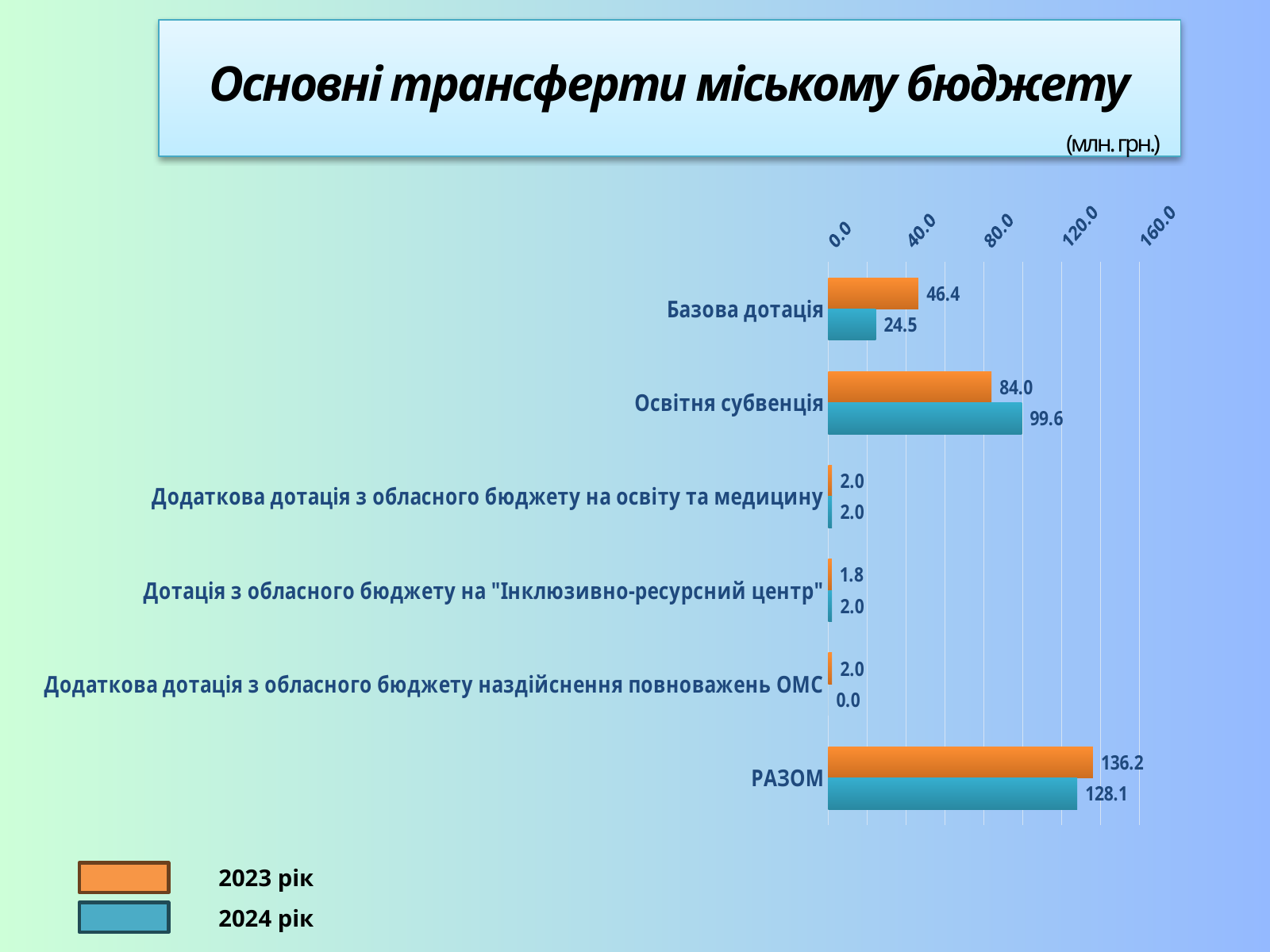
What is the value for Освітня субвенція in 2024 рік? 99.6 What is the difference between the 2023 рік and 2024 рік values for РАЗОМ? 8.1 How many categories are shown on the chart? 6 Excluding РАЗОМ, which category has the highest value in 2024 рік? Освітня субвенція What type of chart is shown on the slide? Bar chart What is the value for Дотація з обласного бюджету на "Інклюзивно-ресурсний центр" in 2023 рік? 1.8 What is the value for Базова дотація in 2023 рік? 46.4 What is the value for РАЗОМ in 2024 рік? 128.1 For Освітня субвенція, which year has the larger value, 2023 рік or 2024 рік? 2024 рік What is the difference between the 2023 рік and 2024 рік values for Базова дотація? 21.9 How many series does the legend list? 2 Which category has the lowest value in 2024 рік? Додаткова дотація з обласного бюджету наздійснення повноважень ОМС